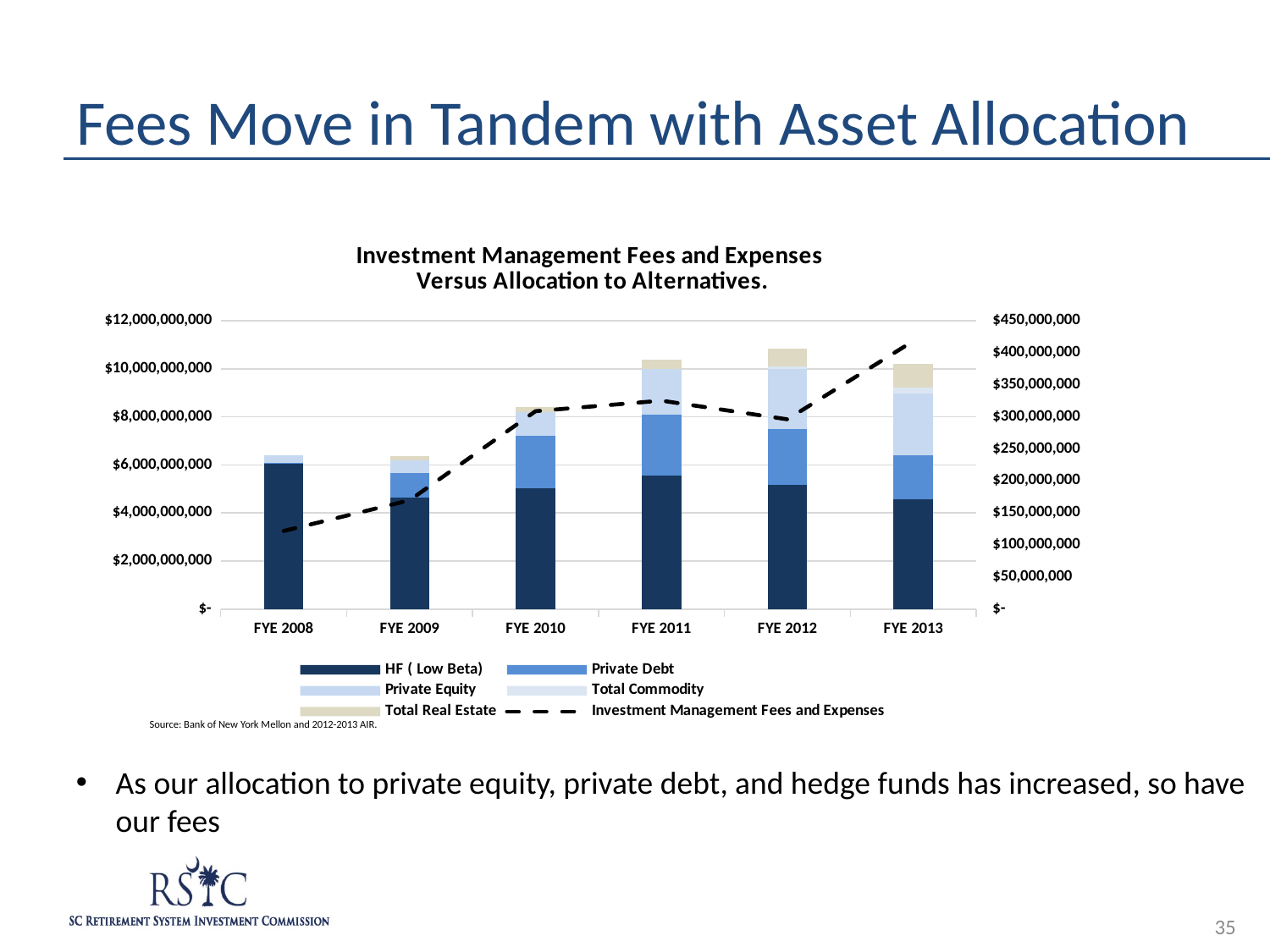
Is the HF (Low Beta) value for FYE 2013 greater or less than $6,000,000,000? less Is the Investment Management Fees and Expenses value for FYE 2013 greater or less than $350,000,000? greater Which series is plotted as a dashed line? Investment Management Fees and Expenses Which is larger, the HF (Low Beta) value for FYE 2008 or for FYE 2013? FYE 2008 Which fiscal year has the tallest stacked bar? FYE 2012 What is the title of the chart? Investment Management Fees and Expenses Versus Allocation to Alternatives. How many series does the legend list? 6 How many fiscal years (categories) are shown on the x axis? 6 Is the total stacked bar for FYE 2012 greater or less than $10,000,000,000? greater What kind of chart is shown on the slide? Stacked bar chart with a dashed line